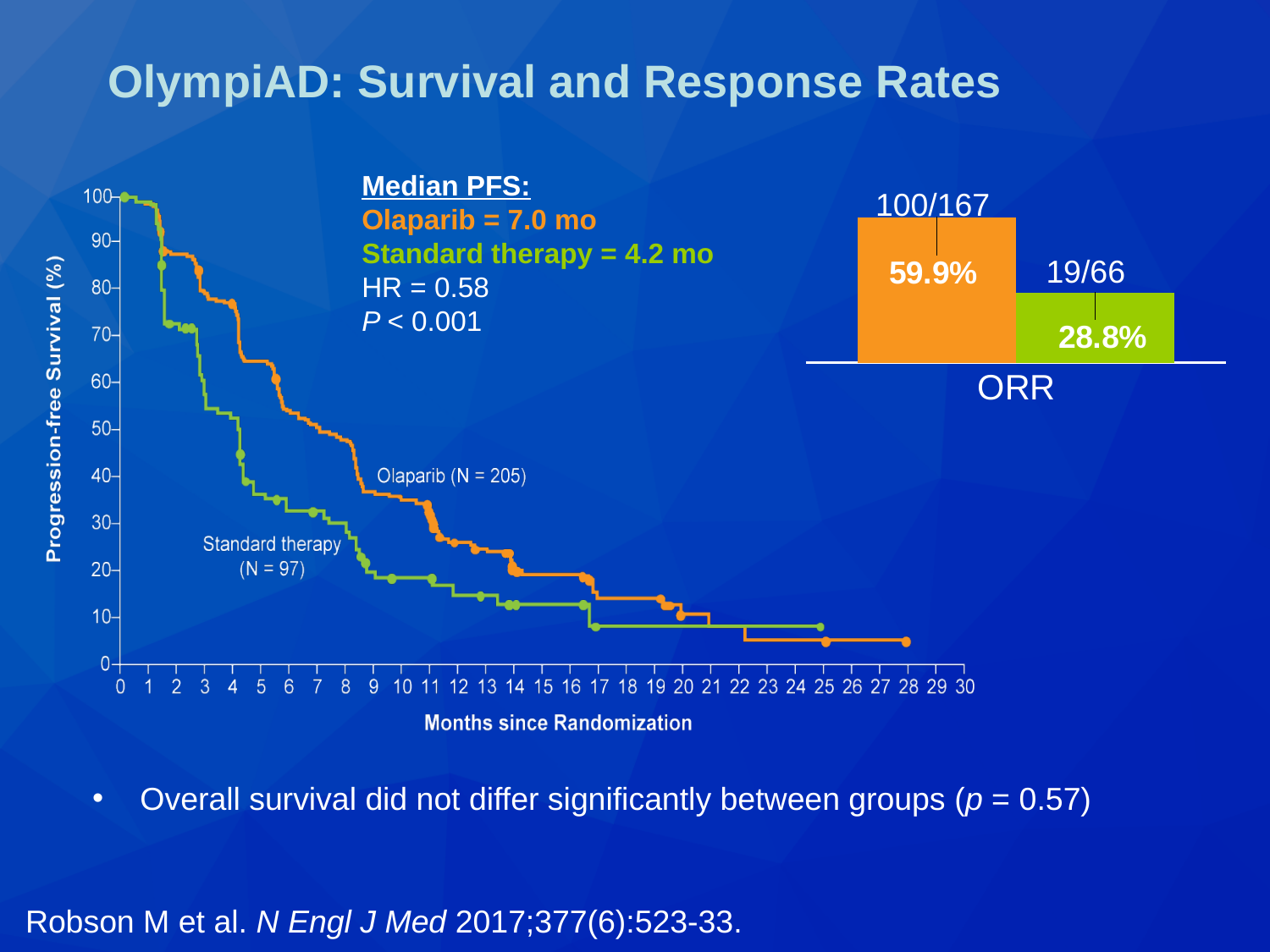
In the ORR bar chart, what is the response rate shown on the green bar? 28.8% In the progression-free survival chart, what is the median PFS for Olaparib? 7.0 mo In the progression-free survival chart, what is the median PFS for standard therapy? 4.2 mo In the progression-free survival chart, what is the label of the x axis? Months since Randomization In the ORR bar chart, how many bars are plotted? 2 In the ORR bar chart, what fraction is printed above the orange bar? 100/167 What kind of chart is the ORR chart on the right of the slide? bar chart In the ORR bar chart, what fraction is printed above the green bar? 19/66 In the ORR bar chart, what is the response rate shown on the orange bar? 59.9% In the progression-free survival chart, is the Olaparib curve at 5 months greater or less than 50%? greater In the ORR bar chart, what is the difference in percentage points between the orange bar and the green bar? 31.1 In the ORR bar chart, which bar is taller, the orange one or the green one? the orange bar